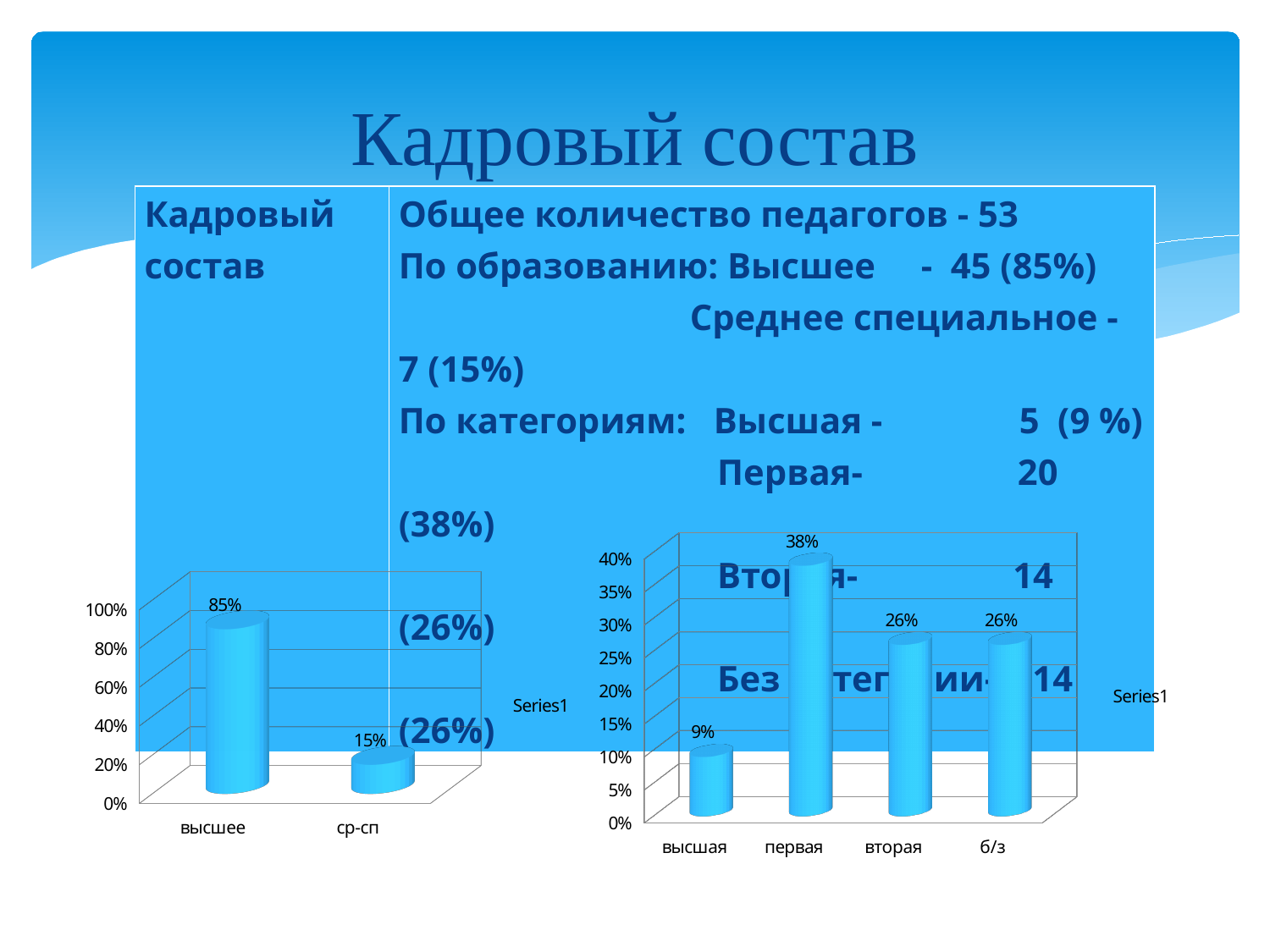
In the left chart, what is the value for ср-сп? 15% In the right chart, which category has the highest value? первая In the right chart, how many categories are shown on the x axis? 4 In the right chart, what is the difference between the values for первая and вторая? 12% What kind of chart is the right chart? bar chart In the right chart, what is the value for высшая? 9% In the right chart, how many series does the legend list? 1 In the right chart, which category has the lowest value? высшая In the left chart, what is the value for высшее? 85% In the right chart, what is the value for первая? 38% In the left chart, how many categories are shown on the x axis? 2 In the left chart, what is the difference between the values for высшее and ср-сп? 70%